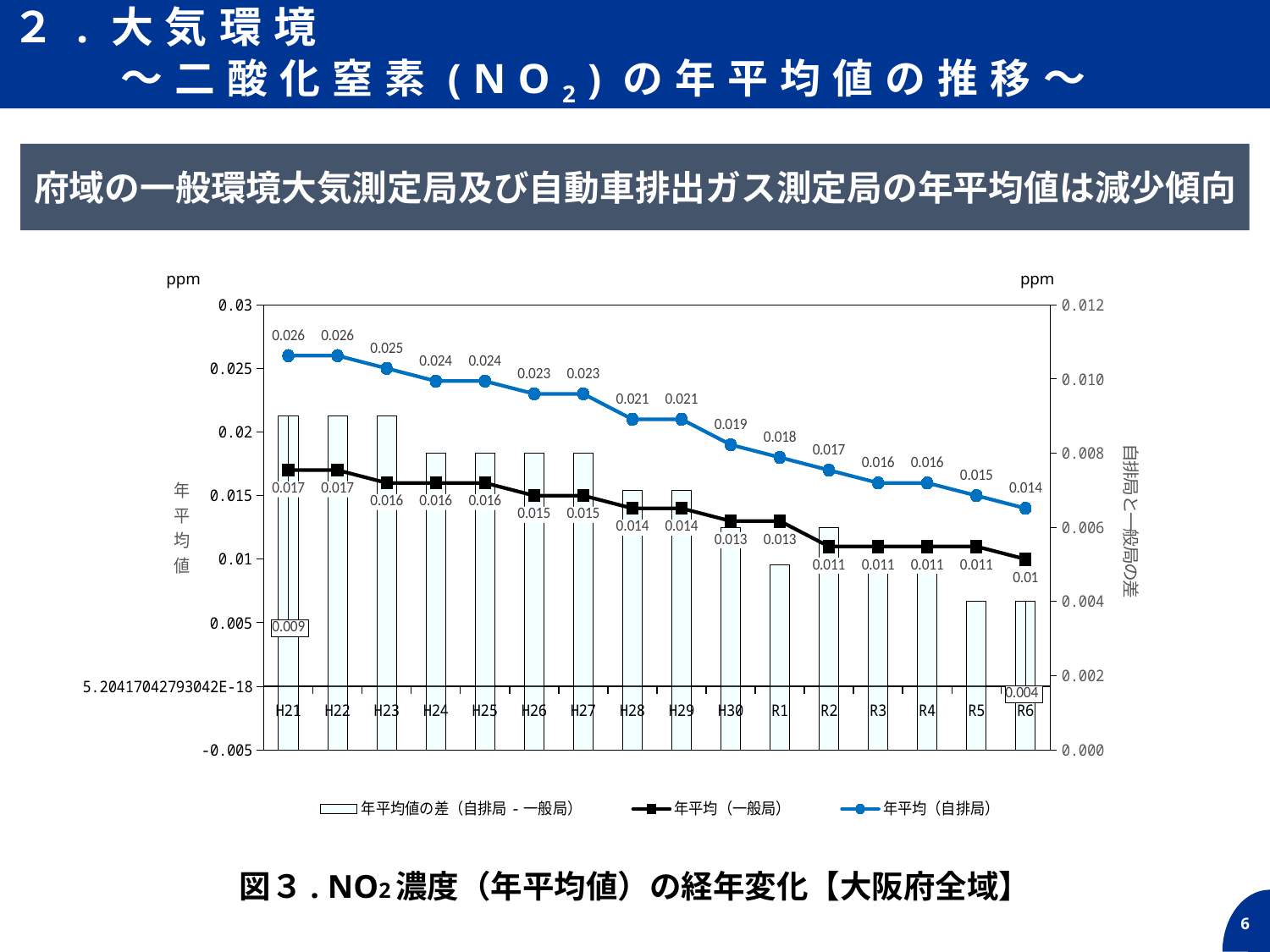
Does the 年平均（一般局） series rise or fall from H21 to R6? Fall What is the value of 年平均（自排局） for H21? 0.026 What is the labelled value of the 年平均値の差（自排局－一般局） bar for H21? 0.009 Which year has the lowest value for 年平均（自排局）? R6 What is the labelled value of the 年平均値の差（自排局－一般局） bar for R6? 0.004 How many years are shown on the x axis of the chart? 16 For R1, which is larger: 年平均（自排局） or 年平均（一般局）? 年平均（自排局） How many series does the legend list? 3 What is the difference between 年平均（自排局） and 年平均（一般局） for H30? 0.006 What kind of chart is shown on the slide? Combined line and bar chart By how much did 年平均（自排局） decrease from H21 to R6? 0.012 What is the value of 年平均（一般局） for R6? 0.01